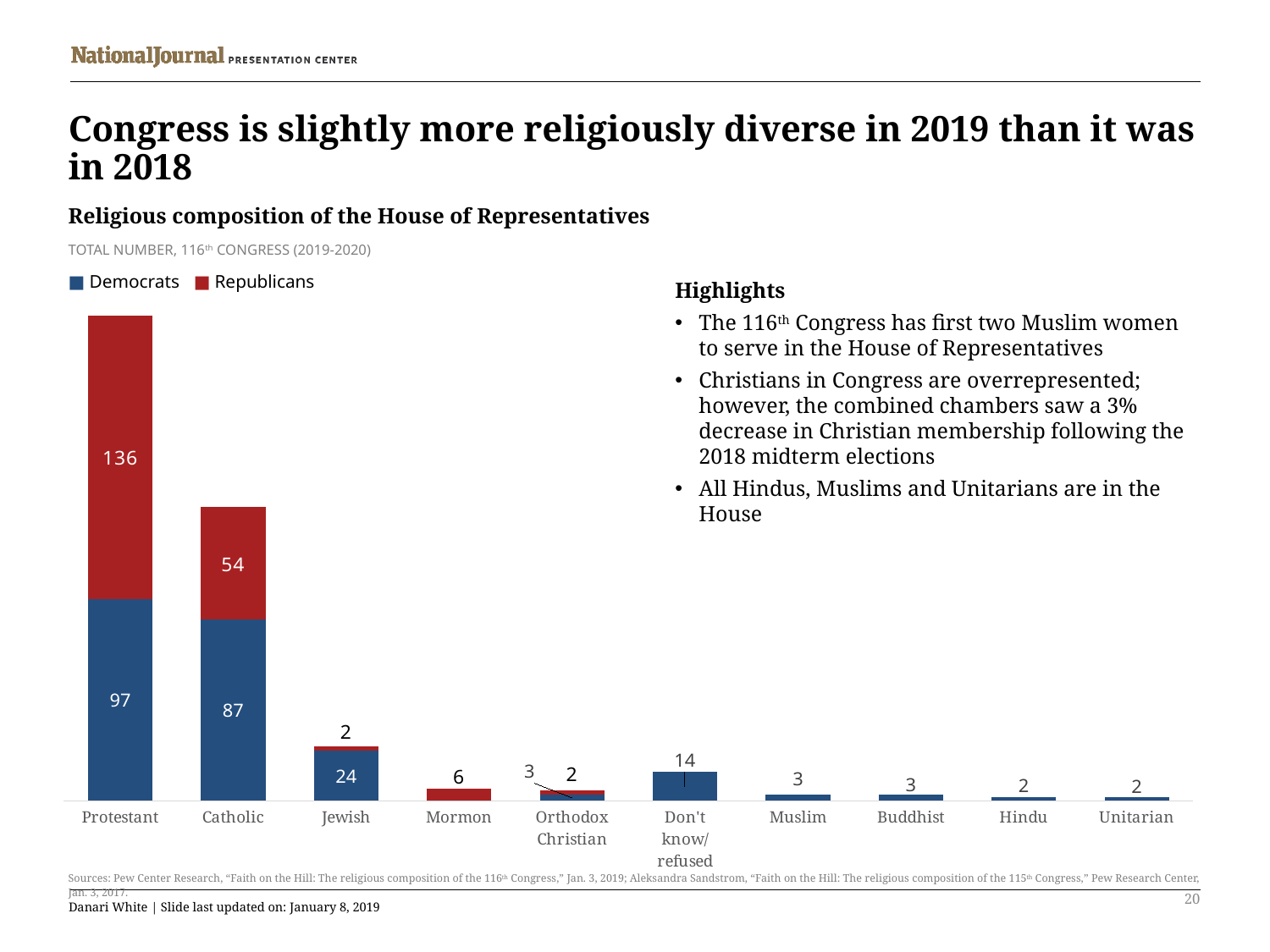
What is the total number of Catholic House members (Democrats plus Republicans)? 141 How many Republicans are Protestant in the House of Representatives? 136 Are there more Democratic Catholics or Republican Catholics in the House? Democratic Catholics How many House members answered 'Don't know/refused' on religion? 14 How many Democrats are Catholic in the House of Representatives? 87 What type of chart is used to show the religious composition of the House of Representatives? Stacked bar chart How many religious categories are shown on the x axis of the chart? 10 Which religious group has the largest total number of House members? Protestant How many series does the chart's legend list? 2 How many Democrats are Jewish in the House of Representatives? 24 What is the total number of Protestant House members (Democrats plus Republicans)? 233 How many more Republican Protestants than Democratic Protestants are there in the House? 39